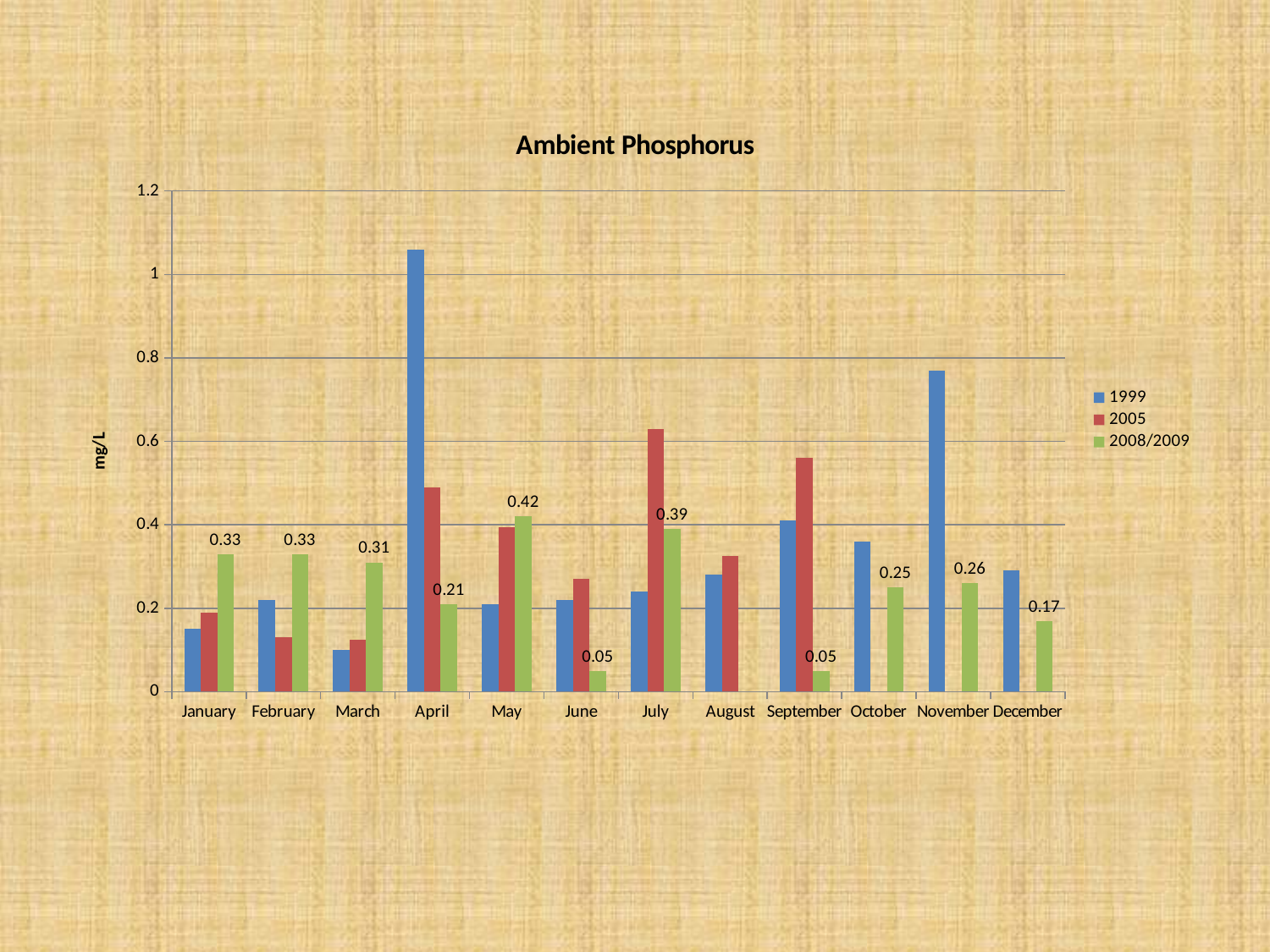
How many series does the legend list? 3 What is the difference between the 2008/2009 values for May and June? 0.37 What is the 2008/2009 value for December? 0.17 How many months are shown on the x axis? 12 Which is larger, the 2008/2009 value for July or for October? July What kind of chart is shown on the slide? bar chart Which month has the highest 2008/2009 value? May Which month has the highest 1999 value? April Is the 1999 value for April greater or less than 1? greater What is the 2008/2009 value for April? 0.21 Is the 1999 value for November greater or less than 0.8? less What is the 2008/2009 value for May? 0.42